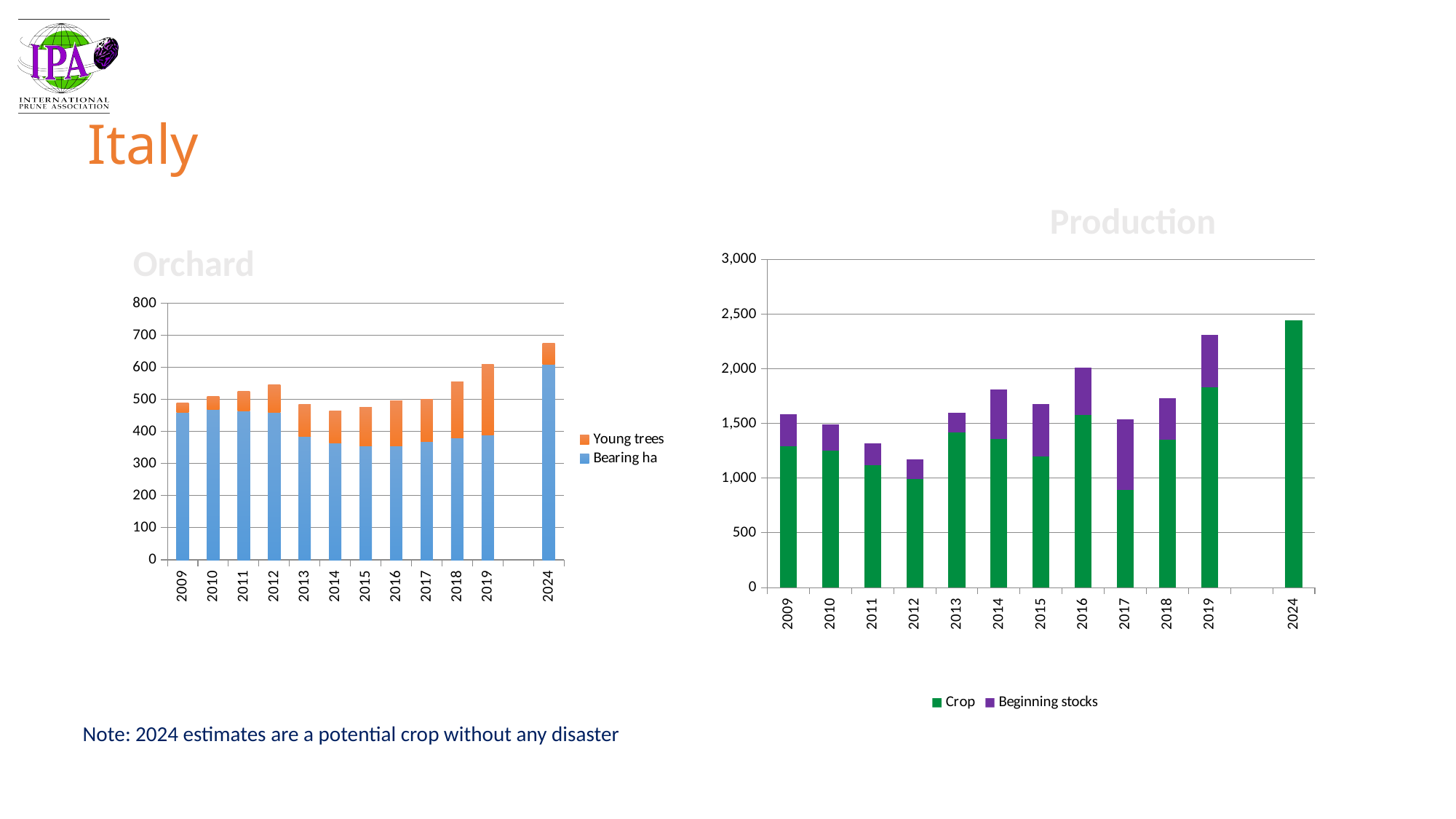
What kind of chart is the Orchard chart? bar chart In the Production chart, which year has the lowest total bar? 2012 In the Orchard chart, which series is shown in orange? Young trees In the Orchard chart, which year has the highest total bar? 2024 In the Production chart, which year has the lowest Crop value? 2017 In the Orchard chart, is the total value for 2012 greater or less than 500? greater In the Orchard chart, is the total value for 2024 greater or less than 600? greater How many years are shown on the x axis of the Orchard chart? 12 In the Production chart, is the total value for 2024 greater or less than 2,000? greater How many series does the legend of the Orchard chart list? 2 In the Production chart, which year has the larger total bar, 2018 or 2019? 2019 How many series does the legend of the Production chart list? 2